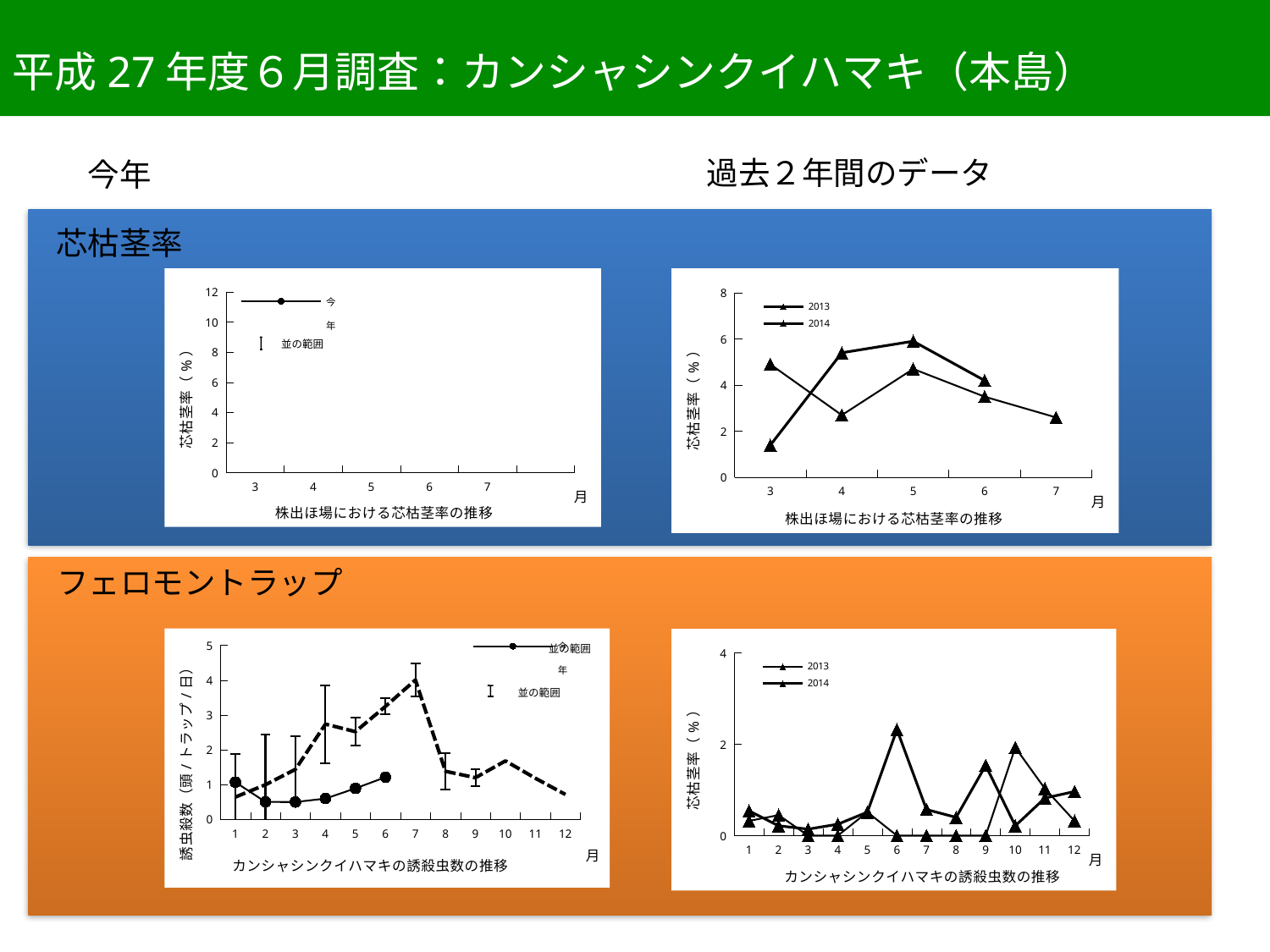
In the bottom-left chart (this year's 誘殺虫数), is the solid circle-marker line value at month 2 greater or less than 1? less In the bottom-right chart (past 2 years 誘殺虫数), is the 2014 value at month 6 greater or less than 2? greater In the top-right chart (past 2 years 芯枯茎率), is the 2014 value at month 3 greater or less than 2? less In the bottom-left chart (this year's カンシャシンクイハマキの誘殺虫数の推移), how many months are shown on the x axis? 12 In the top-right chart (past 2 years 芯枯茎率), how many months are shown on the x axis? 5 What kind of chart is the top-right chart titled 株出ほ場における芯枯茎率の推移 (past 2 years)? line chart In the top-right chart (past 2 years 芯枯茎率), does the 2013 line rise or fall from month 5 to month 7? fall In the top-right chart (past 2 years 芯枯茎率), how many series does the legend list? 2 In the top-left chart (this year's 芯枯茎率), what is the highest tick value shown on the y axis? 12